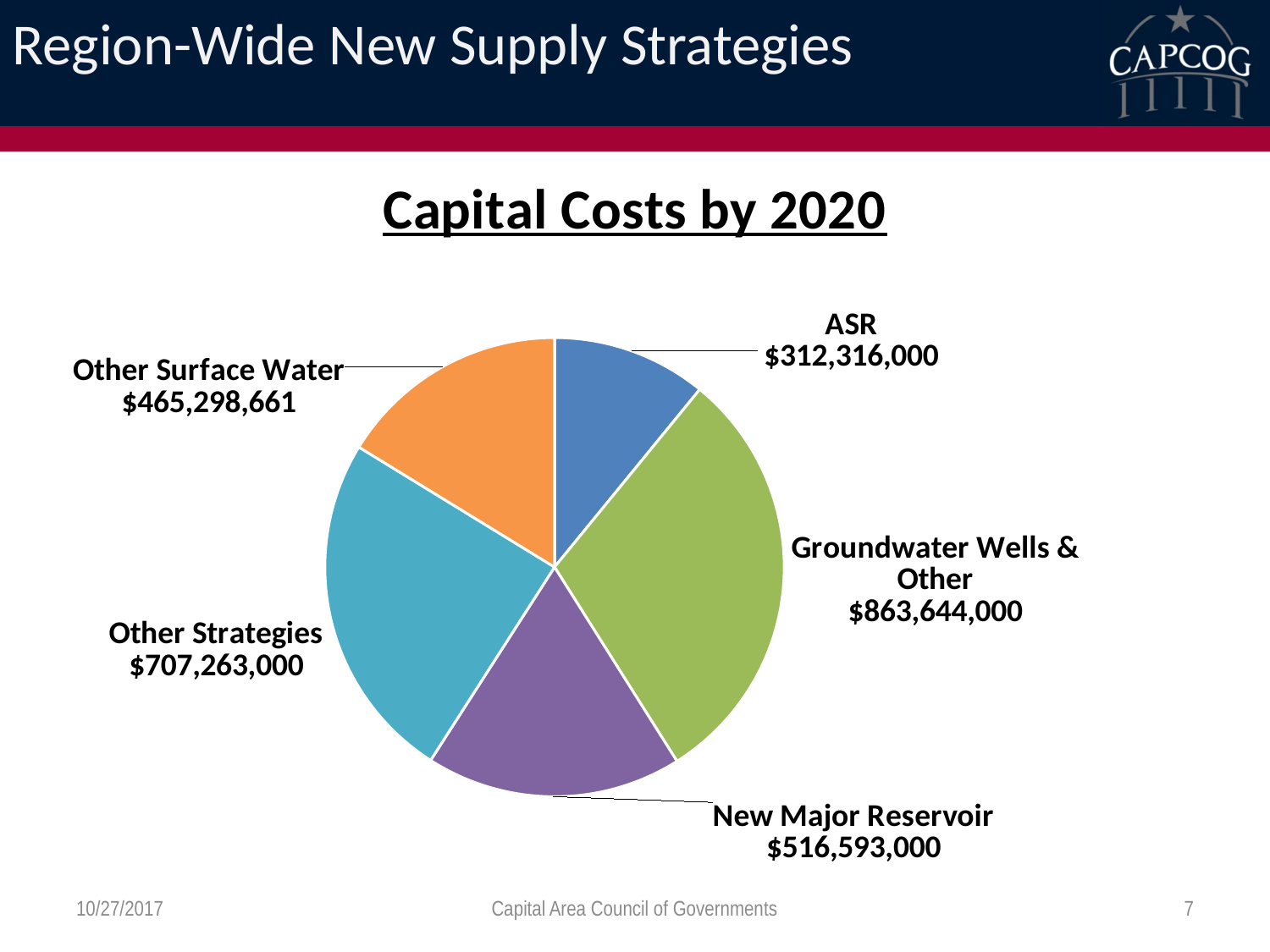
What is the capital cost for ASR? $312,316,000 What is the capital cost for New Major Reservoir? $516,593,000 What is the difference between the capital costs for Groundwater Wells & Other and ASR? $551,328,000 How many categories are shown in the pie chart? 5 What is the title of the chart? Capital Costs by 2020 Which has a larger capital cost, Other Strategies or Other Surface Water? Other Strategies What is the difference between the capital costs for Other Strategies and New Major Reservoir? $190,670,000 Which category has the lowest capital cost? ASR What is the capital cost for Other Surface Water? $465,298,661 What is the capital cost for Groundwater Wells & Other? $863,644,000 Which category has the highest capital cost? Groundwater Wells & Other What type of chart is shown on the slide? Pie chart